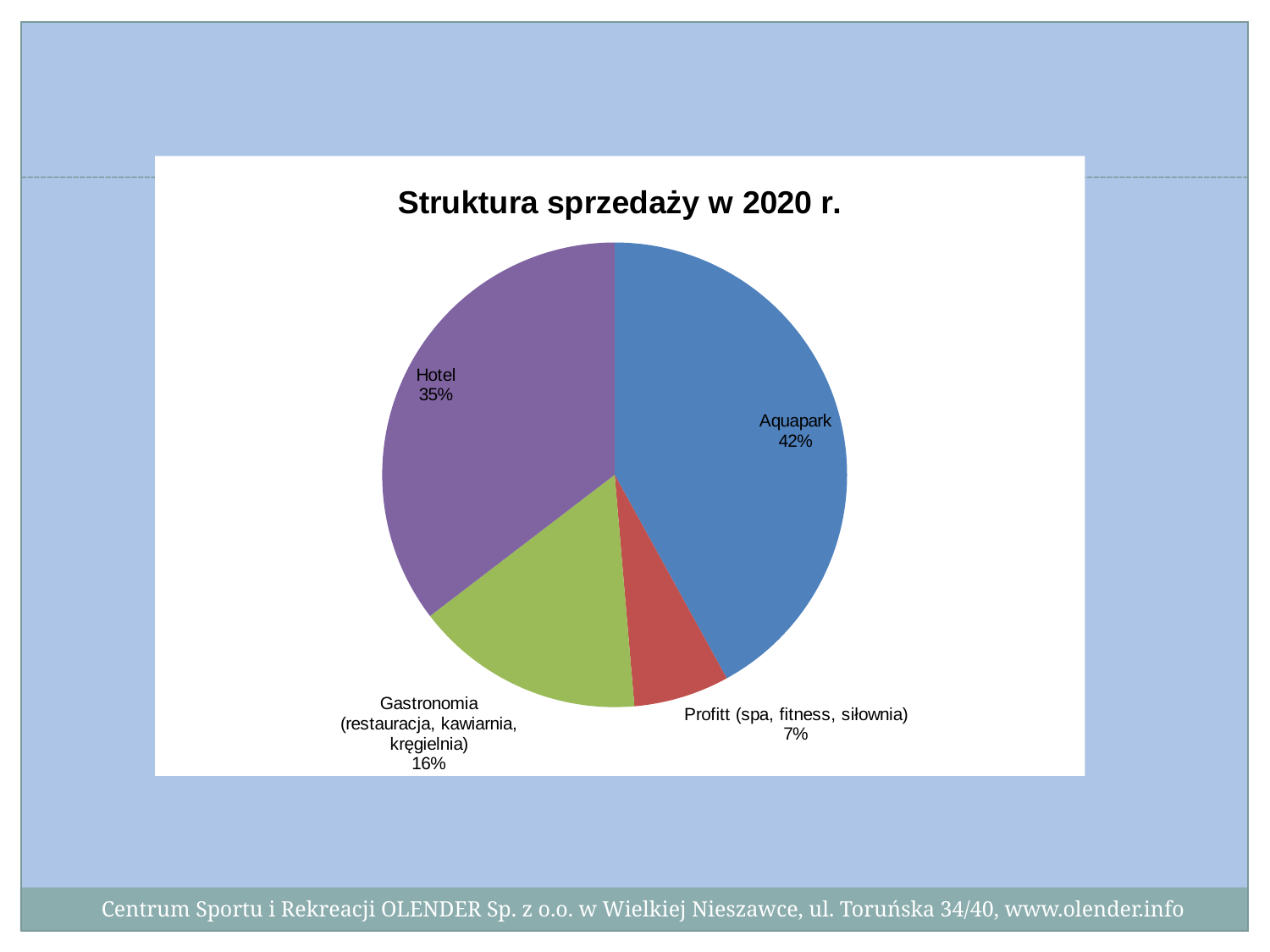
What share of sales does Aquapark account for? 42% What colour is the Aquapark slice? Blue What share of sales does Hotel account for? 35% What is the title of the chart? Struktura sprzedaży w 2020 r. What type of chart is shown on the slide? Pie chart What is the difference in percentage points between Aquapark and Hotel? 7 What share of sales does Gastronomia (restauracja, kawiarnia, kręgielnia) account for? 16% Which has a larger share, Hotel or Gastronomia (restauracja, kawiarnia, kręgielnia)? Hotel What share of sales does Profitt (spa, fitness, siłownia) account for? 7% How many categories are shown in the pie chart? 4 Which category has the smallest share of sales? Profitt (spa, fitness, siłownia) Which category has the largest share of sales? Aquapark